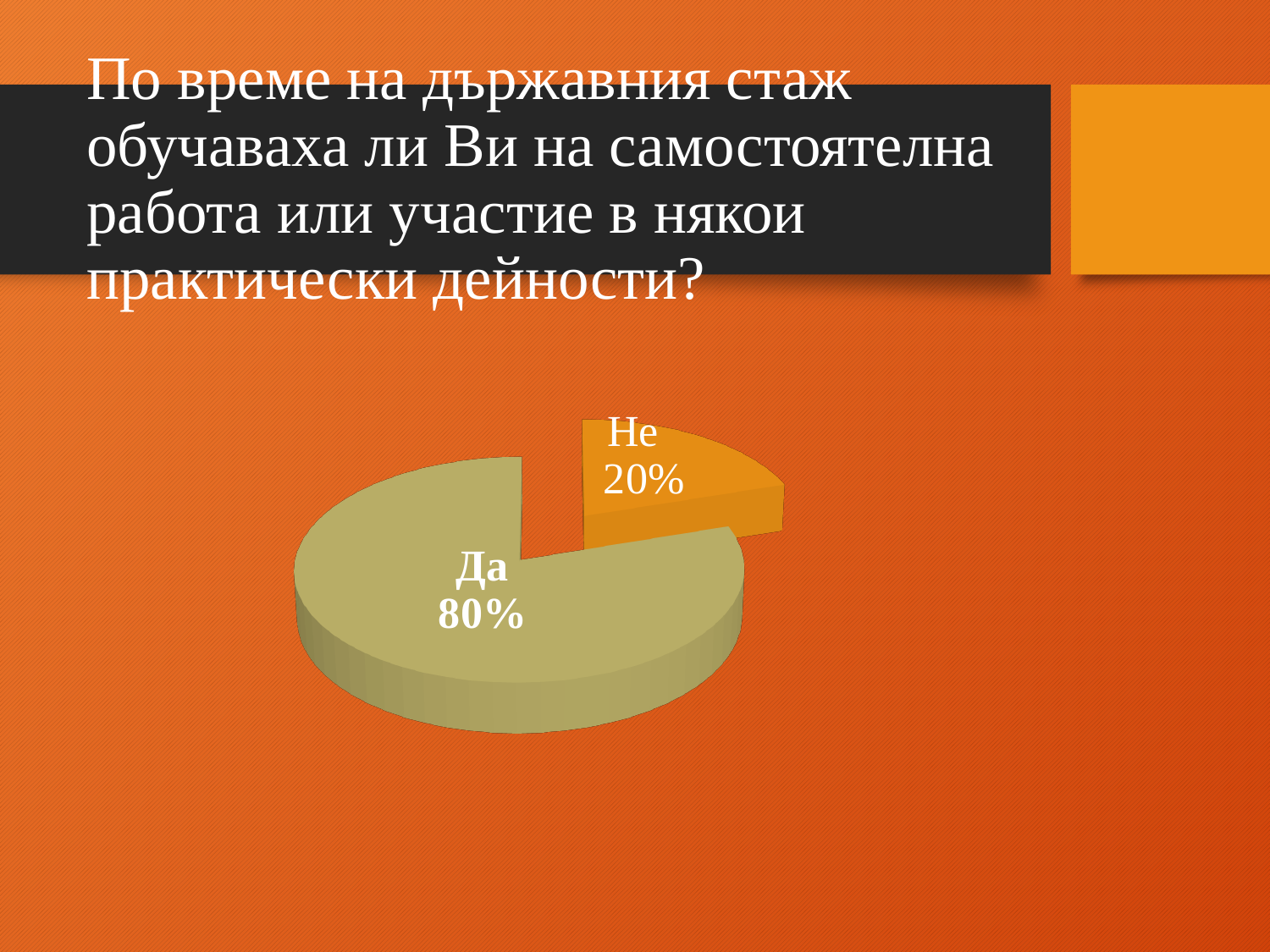
What kind of chart is shown on the slide? pie chart Which slice of the pie is the largest? Да What share of the pie does the "Не" slice represent? 20% What is the difference in percentage points between the "Да" and "Не" slices? 60 What colour is the "Не" slice of the pie chart? orange What is the total of the two slice percentages shown on the pie chart? 100% What share of the pie does the "Да" slice represent? 80% Which slice is pulled out (exploded) from the pie chart? Не How many slices does the pie chart have? 2 Which is larger, the "Да" slice or the "Не" slice? Да Which slice of the pie is the smallest? Не